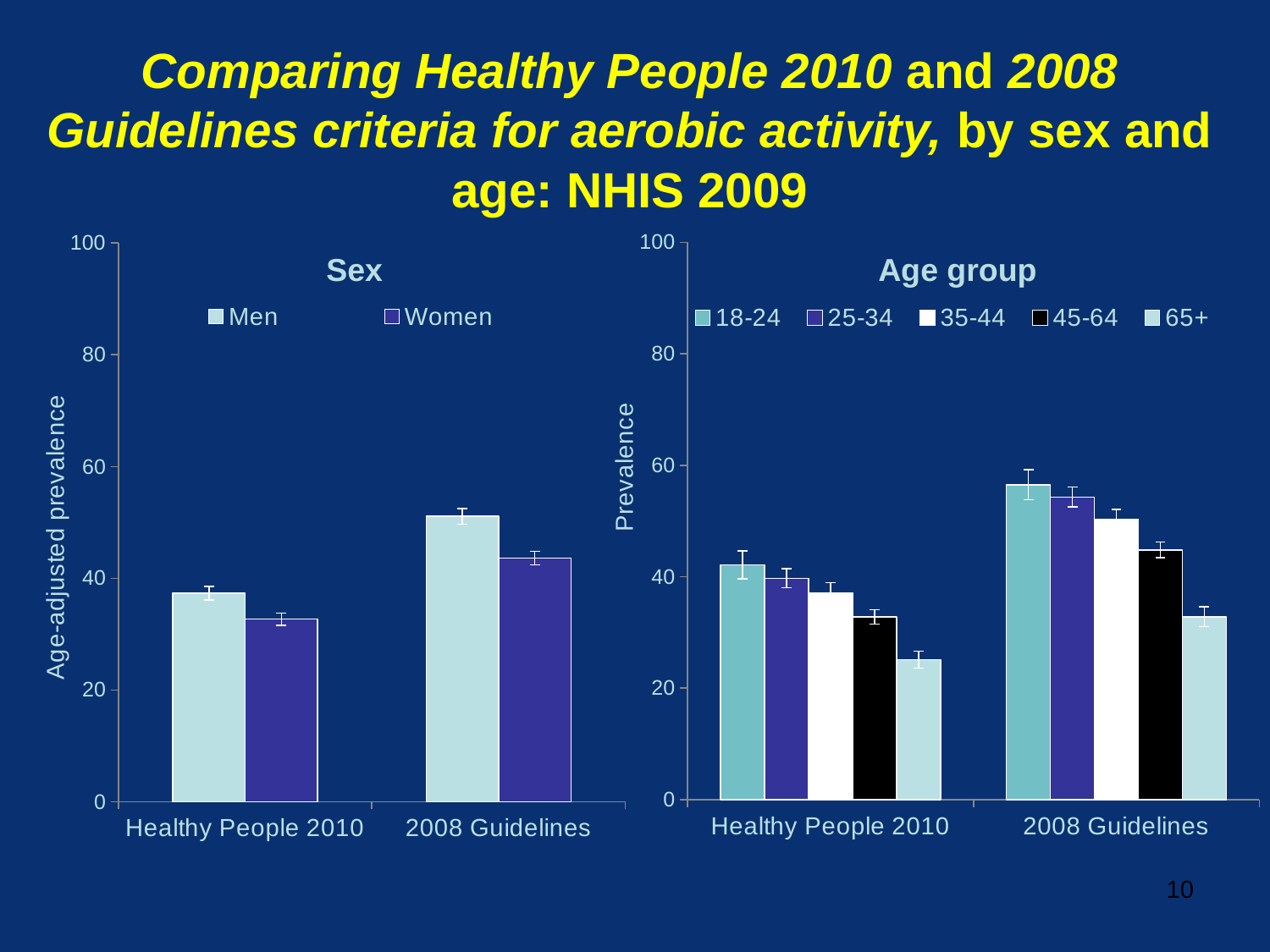
What is the y-axis label of the "Sex" chart? Age-adjusted prevalence In the "Age group" chart, is the value for 45-64 under 2008 Guidelines greater or less than 60? less In the "Sex" chart, is the value for Women under Healthy People 2010 greater or less than 40? less How many series does the legend of the "Age group" chart list? 5 In the "Age group" chart, which age group has the lowest value under Healthy People 2010? 65+ In the "Sex" chart, is the value for Men under 2008 Guidelines greater or less than 40? greater How many categories are shown on the x axis of the "Age group" chart? 2 In the "Sex" chart, which is larger under Healthy People 2010, Men or Women? Men How many series does the legend of the "Sex" chart list? 2 What kind of chart is the "Sex" chart on the left? bar chart In the "Age group" chart, which age group has the highest value under 2008 Guidelines? 18-24